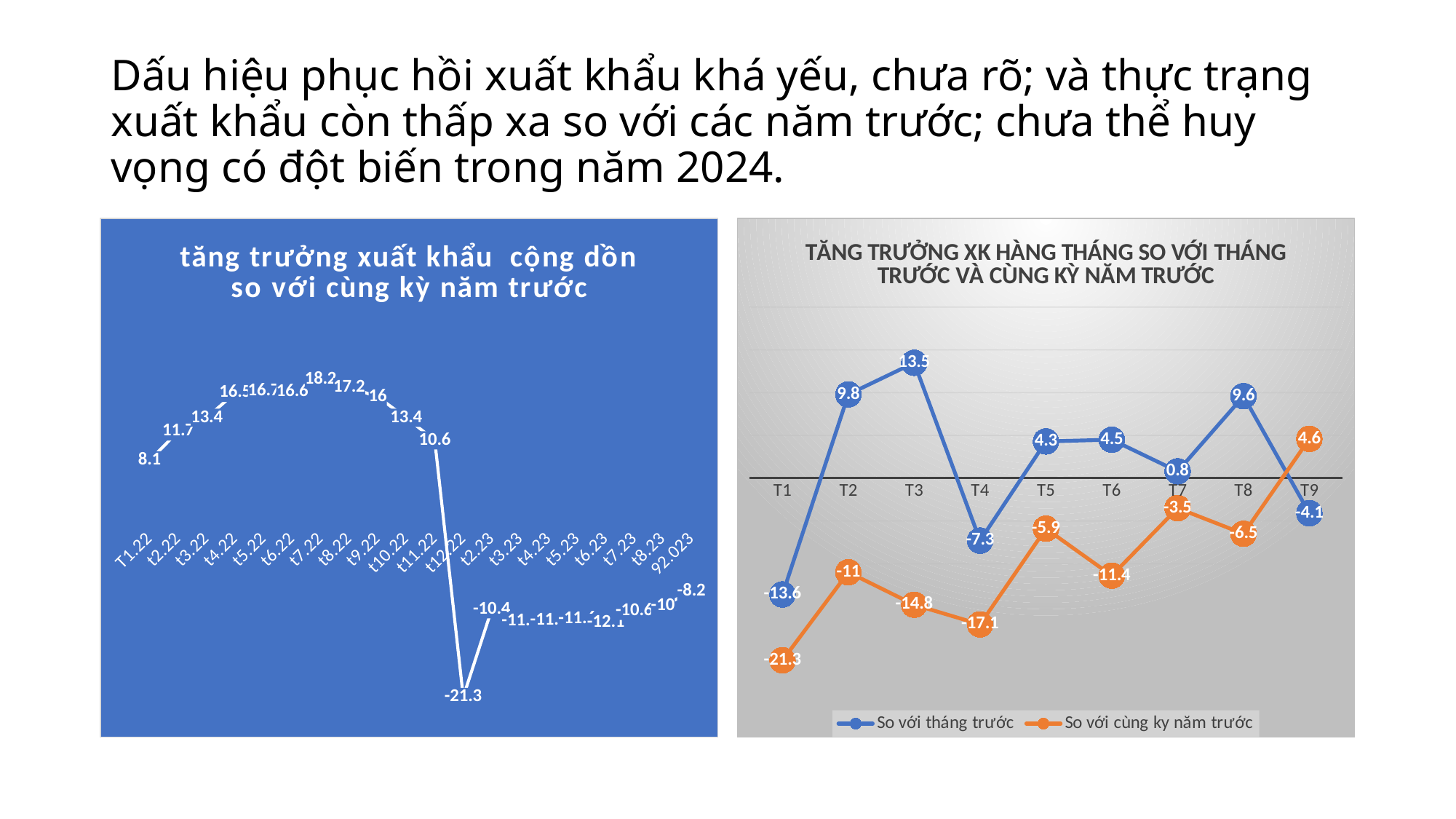
In the right chart, how many months are plotted on the x axis? 9 In the right chart, which series has the larger value at T9? So với cùng ky năm trước In the right chart, at which month is 'So với cùng ky năm trước' lowest? T1 What kind of chart is the left chart (tăng trưởng xuất khẩu cộng dồn so với cùng kỳ năm trước)? line chart In the left chart, what is the value for t12.22? -21.3 In the right chart, what is the difference between 'So với tháng trước' and 'So với cùng ky năm trước' at T4? 9.8 In the right chart, at which month is 'So với tháng trước' highest? T3 In the right chart, what is the value of 'So với cùng ky năm trước' at T1? -21.3 In the right chart, how many series does the legend list? 2 In the left chart, which category has the highest value? t7.22 In the right chart, what is the value of 'So với tháng trước' at T9? -4.1 In the right chart (TĂNG TRƯỞNG XK HÀNG THÁNG...), what is the value of 'So với tháng trước' at T3? 13.5